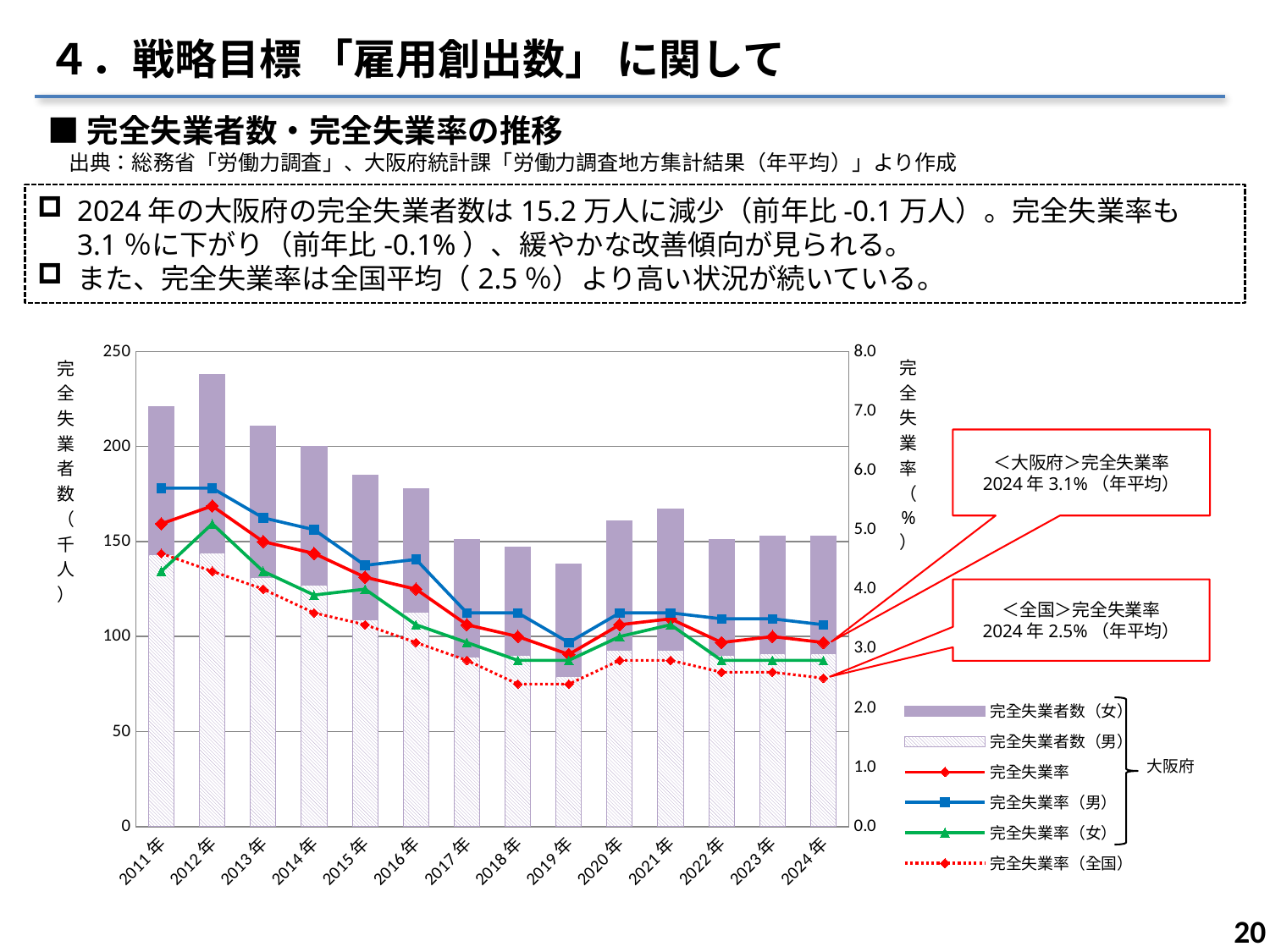
Is the total number of unemployed persons in 2012 greater or less than 200 thousand? greater In 2024, which is higher: the male unemployment rate (完全失業率（男）) or the female unemployment rate (完全失業率（女）)? 完全失業率（男） By how many percentage points did Osaka Prefecture's 2024 unemployment rate exceed the national rate, based on the callout values? 0.6% According to the callout, what was Osaka Prefecture's unemployment rate (完全失業率) in 2024? 3.1% What kind of chart is shown on the slide? A combined bar and line chart Overall, does the total number of unemployed persons rise or fall from 2011 to 2024? fall According to the callout, what was the national (全国) unemployment rate in 2024? 2.5% How many series does the chart's legend list? 6 Is the total number of unemployed persons in 2019 greater or less than 150 thousand? less In which year is the total stacked bar of unemployed persons (完全失業者数) the lowest? 2019年 How many years are plotted along the x axis of the chart? 14 In which year is the total stacked bar of unemployed persons (完全失業者数) the highest? 2012年